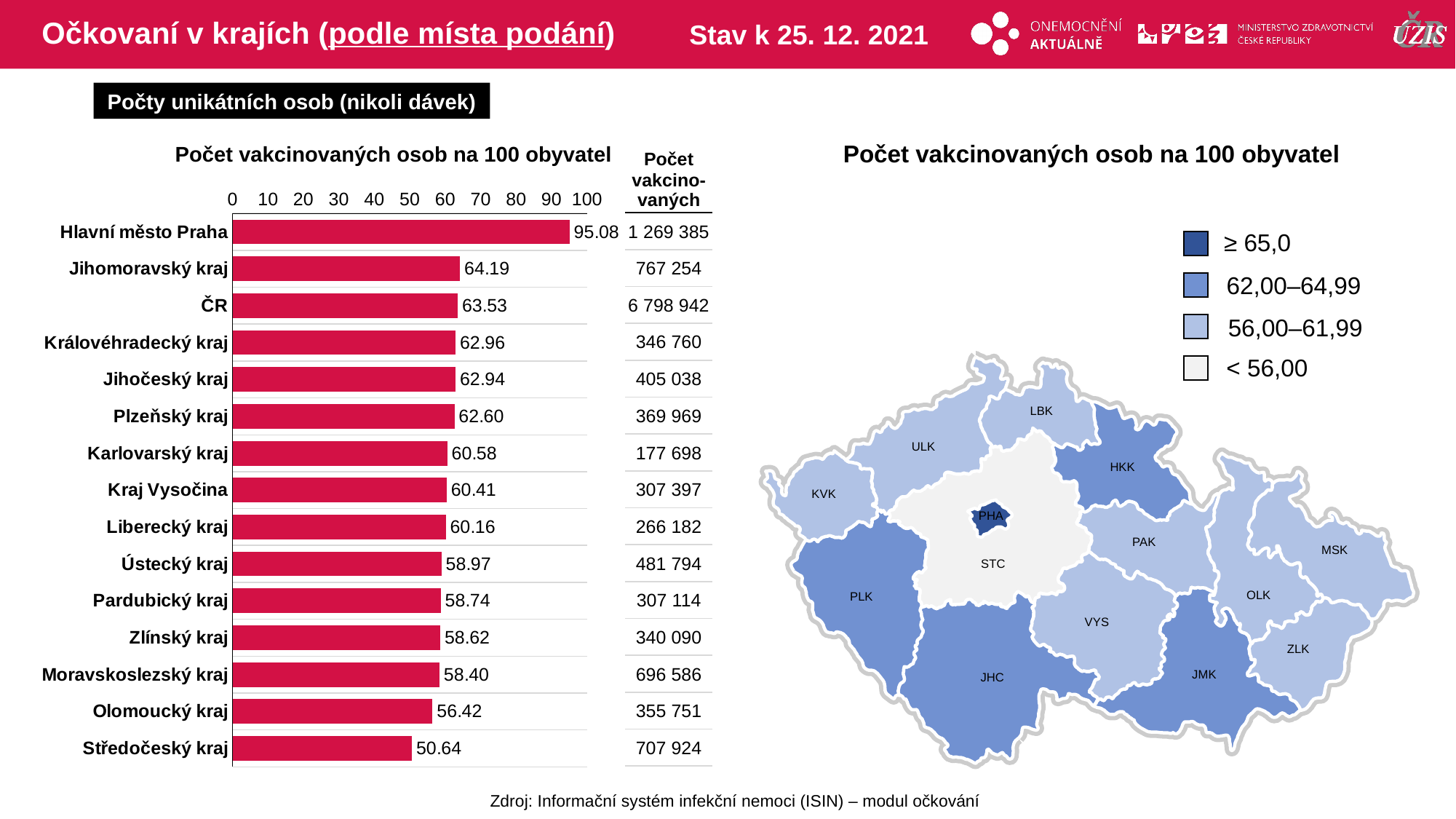
In the bar chart, which has a higher value: Karlovarský kraj or Olomoucký kraj? Karlovarský kraj In the bar chart, which region has the lowest number of vaccinated persons per 100 inhabitants? Středočeský kraj In the bar chart, which region has the highest number of vaccinated persons per 100 inhabitants? Hlavní město Praha What kind of chart is used on the left side of the slide to show the number of vaccinated persons per 100 inhabitants? bar chart What is the title of the bar chart on the left? Počet vakcinovaných osob na 100 obyvatel In the bar chart, what is the value for Kraj Vysočina? 60.41 In the bar chart, is the value for Olomoucký kraj greater or less than 60? less In the bar chart, what is the value for Středočeský kraj? 50.64 In the bar chart, what is the value for ČR? 63.53 In the bar chart, what is the difference between the values for Hlavní město Praha and Středočeský kraj? 44.44 How many categories (bars) does the bar chart show? 15 In the bar chart, what is the number of vaccinated persons per 100 inhabitants for Hlavní město Praha? 95.08